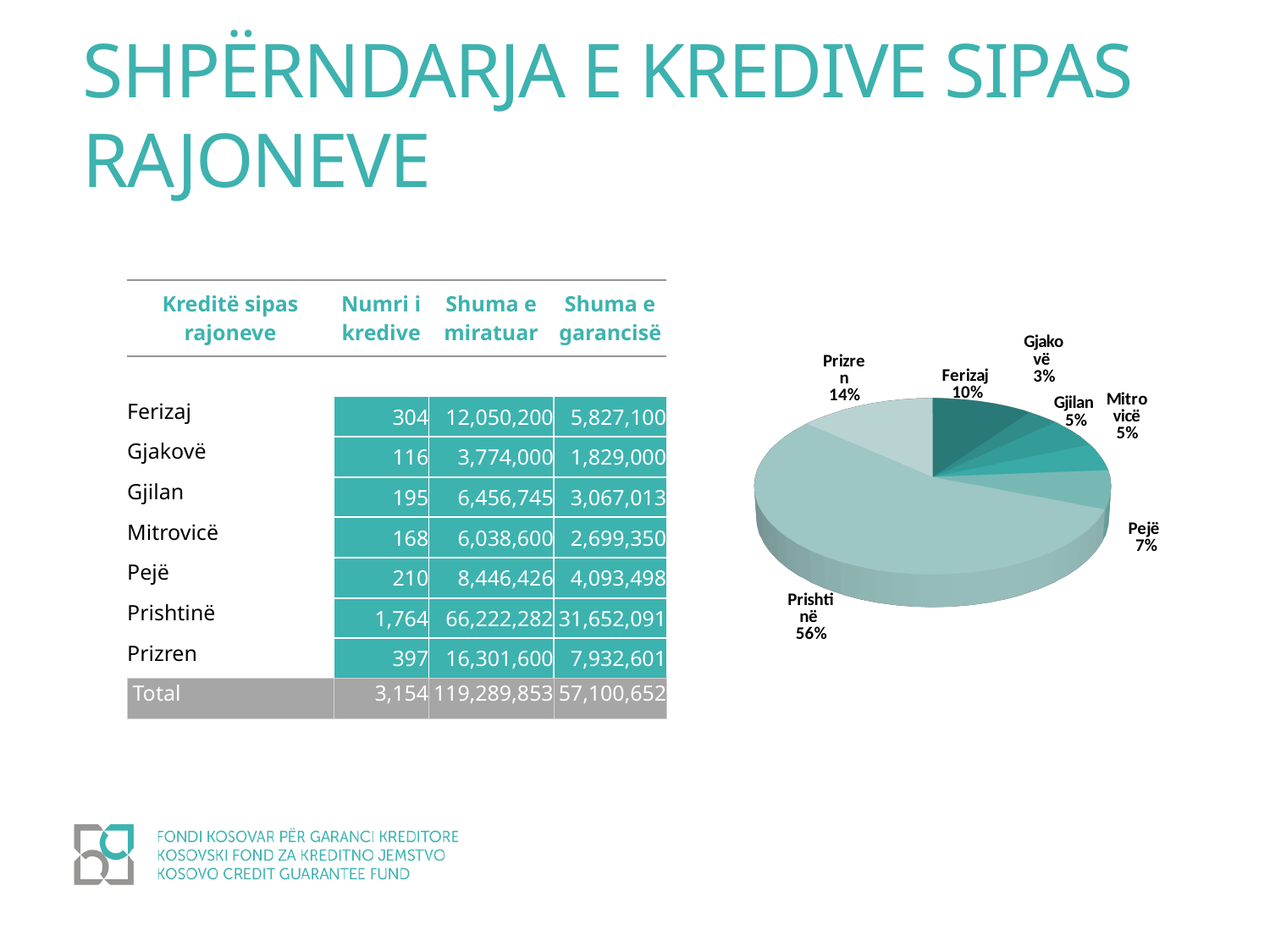
What share of the pie chart does Ferizaj hold? 10% What kind of chart is shown on the slide? pie chart Which region has the largest slice in the pie chart? Prishtinë What share of the pie chart does Gjakovë hold? 3% Which region has the smallest slice in the pie chart? Gjakovë What share of the pie chart does Prishtinë hold? 56% Which slice is larger in the pie chart, Prizren or Ferizaj? Prizren Which two regions each hold a 5% share in the pie chart? Gjilan and Mitrovicë How many slices does the pie chart have? 7 What is the difference in percentage points between the Prishtinë slice and the Prizren slice? 42